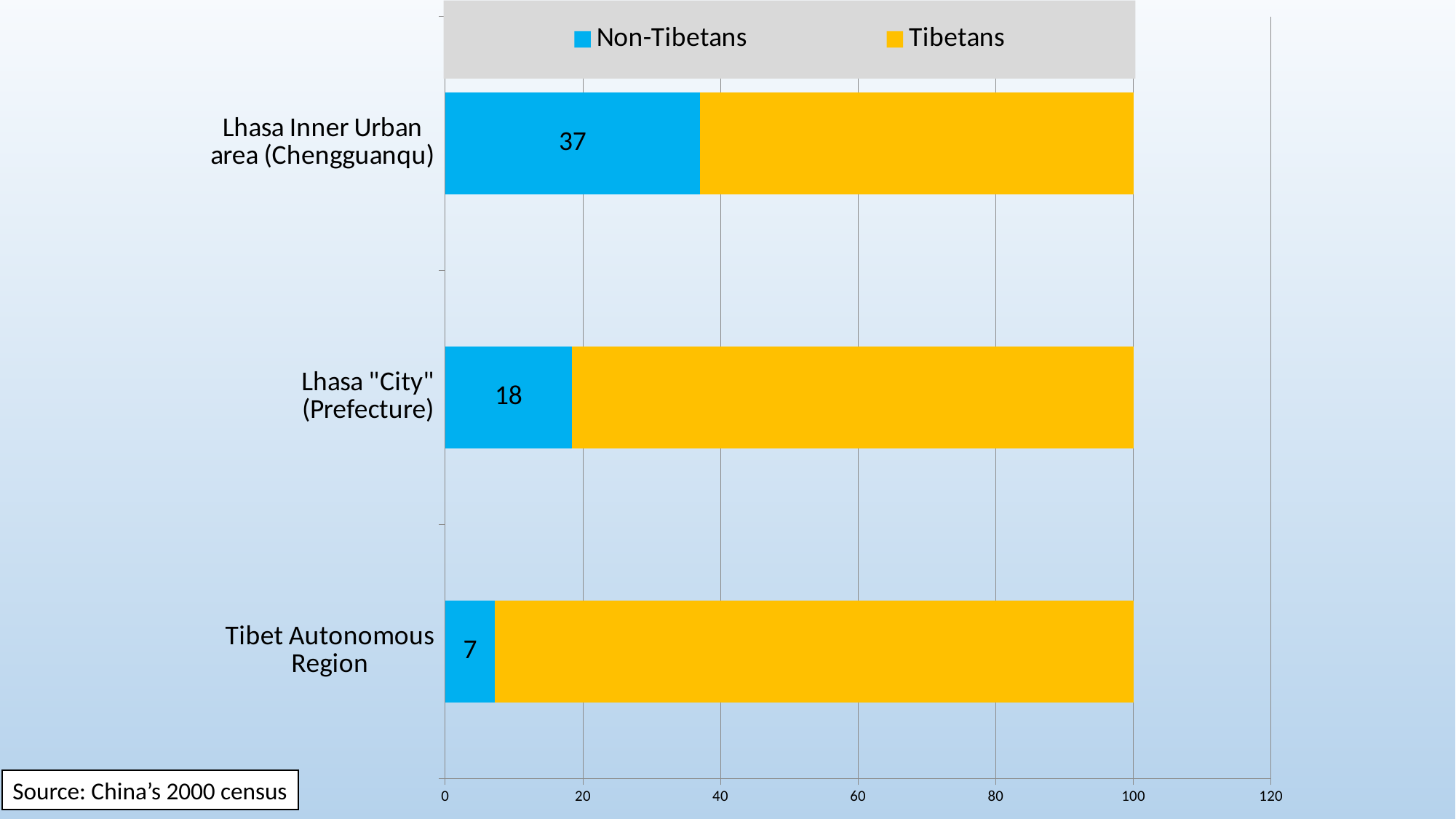
What is the value for Non-Tibetans in the Lhasa Inner Urban area (Chengguanqu)? 37 Which category has the highest Non-Tibetans value? Lhasa Inner Urban area (Chengguanqu) Is the total length of the stacked bar for the Tibet Autonomous Region greater or less than 80? greater What is the difference between the Non-Tibetans values for Lhasa "City" (Prefecture) and the Tibet Autonomous Region? 11 How many categories are shown on the chart? 3 Which has a larger Non-Tibetans value, Lhasa "City" (Prefecture) or the Tibet Autonomous Region? Lhasa "City" (Prefecture) What is the difference between the Non-Tibetans values for the Lhasa Inner Urban area (Chengguanqu) and Lhasa "City" (Prefecture)? 19 Which category has the lowest Non-Tibetans value? Tibet Autonomous Region What is the value for Non-Tibetans in Lhasa "City" (Prefecture)? 18 What kind of chart is shown on the slide? Stacked bar chart What is the value for Non-Tibetans in the Tibet Autonomous Region? 7 How many series does the legend list? 2